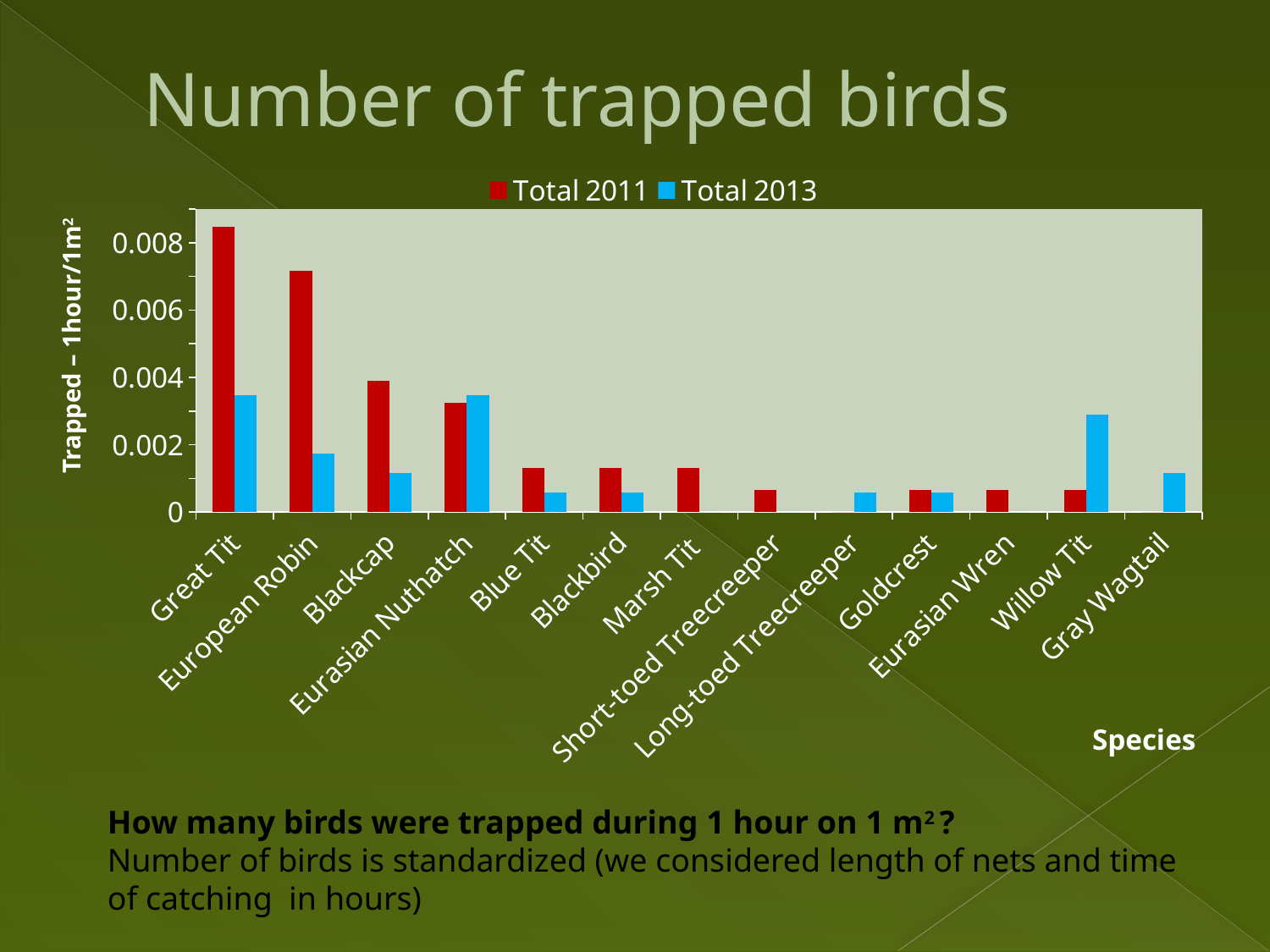
How many species are shown on the x axis? 13 Is the Total 2011 value for European Robin greater or less than 0.006? greater Which has the larger Total 2011 value: Great Tit or European Robin? Great Tit How many series does the legend list? 2 Is the Total 2011 value for Great Tit greater or less than 0.006? greater What is the title of the x axis? Species Is the Total 2013 value for Willow Tit greater or less than 0.002? greater For Great Tit, which is larger: Total 2011 or Total 2013? Total 2011 Which species has the highest Total 2011 value? Great Tit For Willow Tit, which is larger: Total 2011 or Total 2013? Total 2013 What kind of chart is shown on the slide? Bar chart